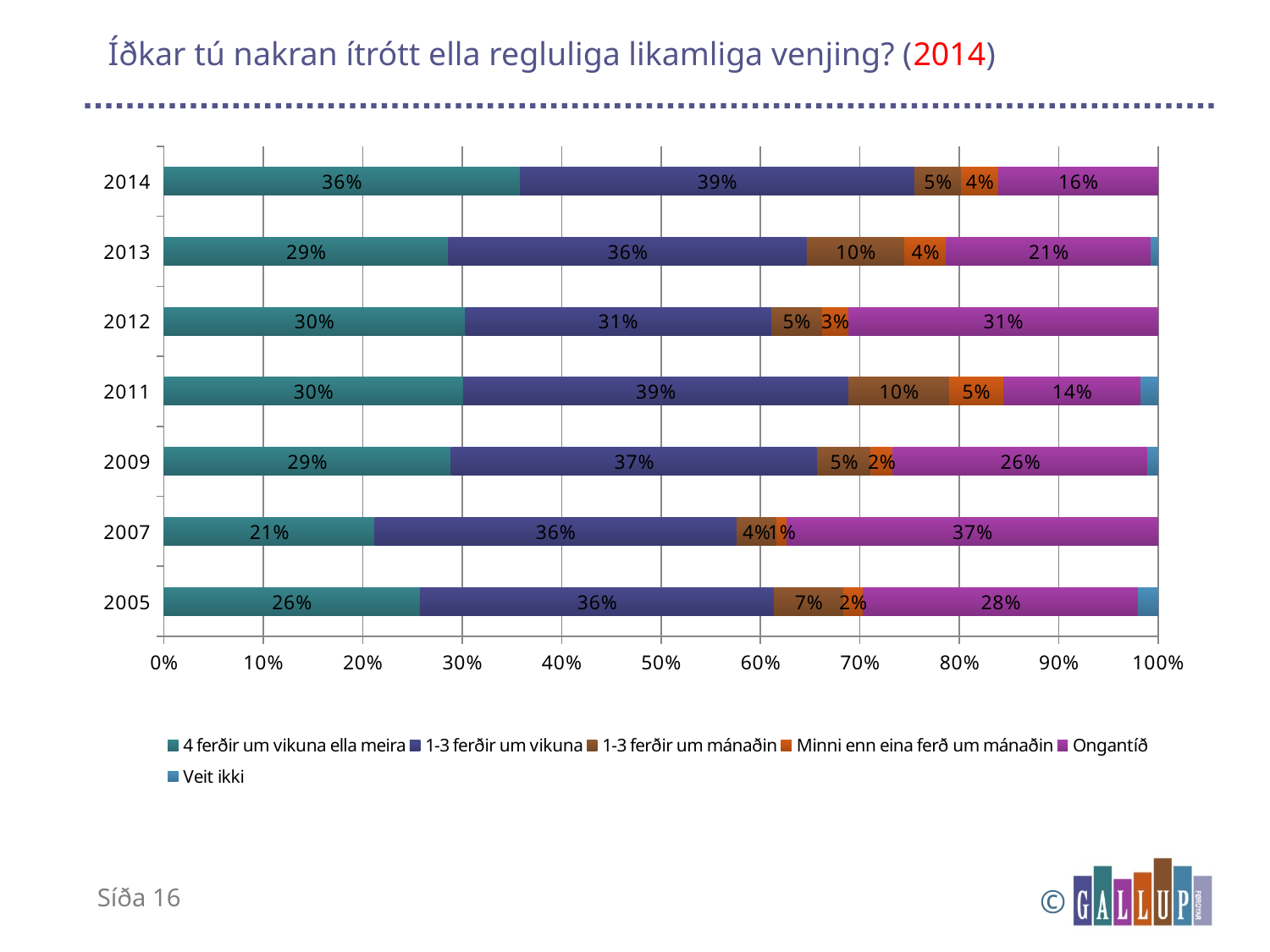
How many years are shown on the y axis? 7 In which year is the value for 'Ongantíð' the highest? 2007 In which year is the value for '4 ferðir um vikuna ella meira' the lowest? 2007 What type of chart is shown on the slide? stacked bar chart What is the difference between the 'Ongantíð' values for 2012 and 2014? 15% Which is larger: '1-3 ferðir um vikuna' in 2011 or in 2012? 2011 What is the value for '4 ferðir um vikuna ella meira' in 2014? 36% What is the value for 'Ongantíð' in 2007? 37% How many series does the legend list? 6 Does the value for 'Ongantíð' rise or fall from 2012 to 2014? fall What is the value for '1-3 ferðir um mánaðin' in 2013? 10% What is the total of the labelled segments in the 2014 bar? 100%